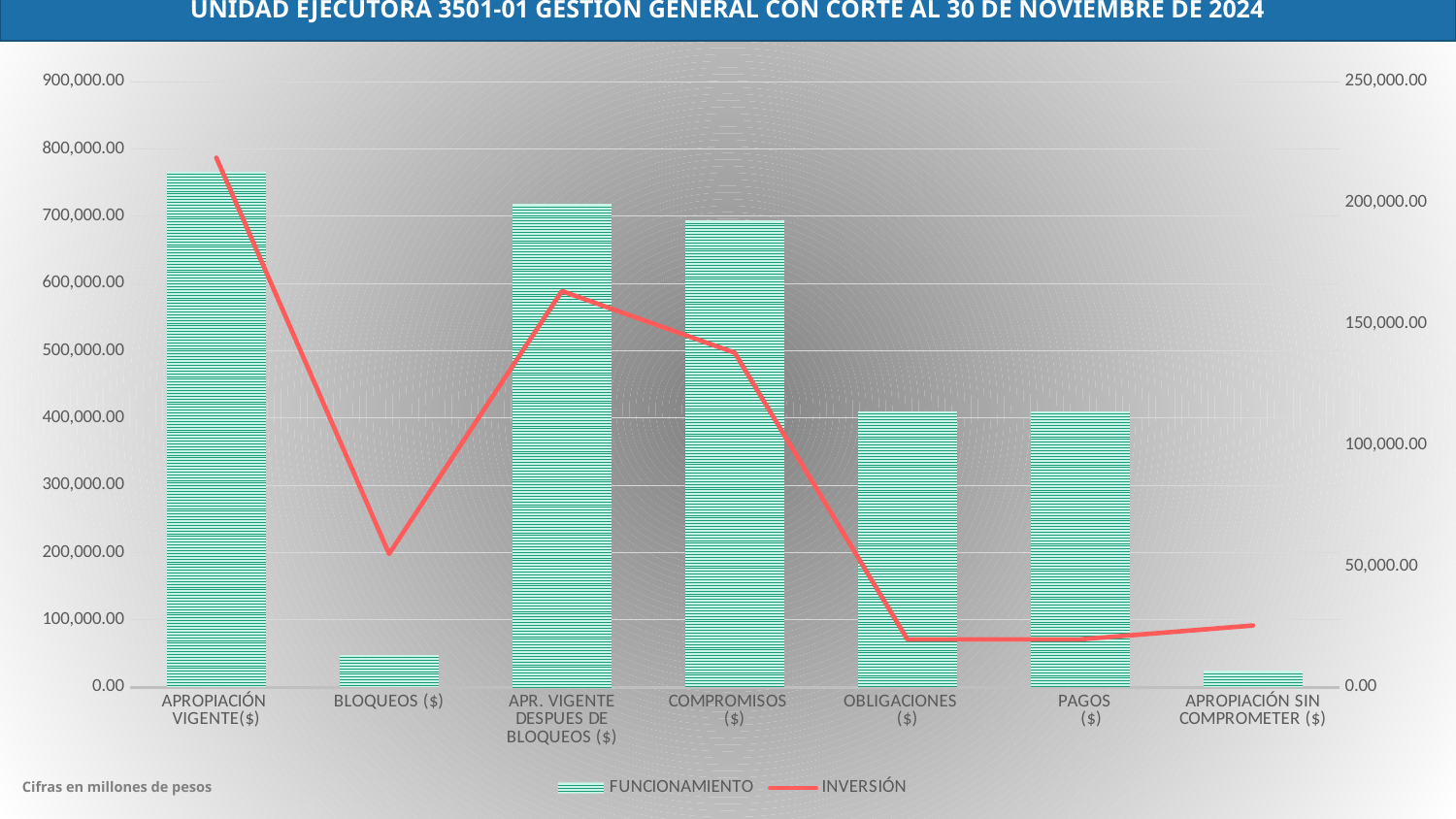
What kind of chart is shown on the slide? A combined bar and line chart Is the INVERSIÓN value for BLOQUEOS ($) greater or less than 100,000.00 on the right axis? less At which category does the INVERSIÓN line reach its highest point? APROPIACIÓN VIGENTE($) Which category has the highest FUNCIONAMIENTO bar? APROPIACIÓN VIGENTE($) How many series does the legend list? 2 What are the two series named in the legend? FUNCIONAMIENTO and INVERSIÓN Which has the larger FUNCIONAMIENTO value, APROPIACIÓN VIGENTE($) or COMPROMISOS ($)? APROPIACIÓN VIGENTE($) Is the INVERSIÓN value for APR. VIGENTE DESPUES DE BLOQUEOS ($) greater or less than 150,000.00 on the right axis? greater How many categories are shown along the x axis? 7 Which category has the lowest FUNCIONAMIENTO bar? APROPIACIÓN SIN COMPROMETER ($) Is the FUNCIONAMIENTO value for BLOQUEOS ($) greater or less than 100,000.00? less